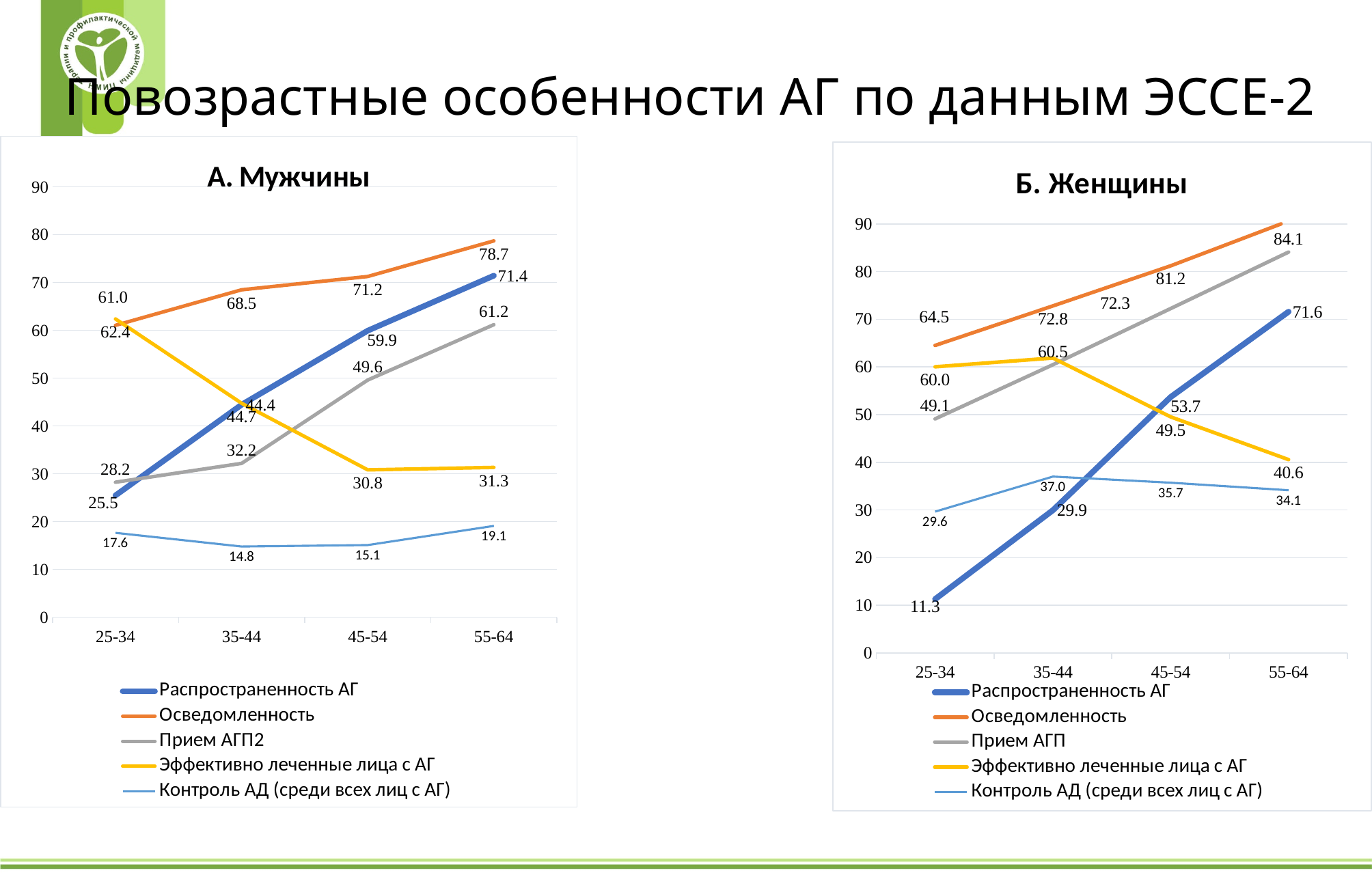
In the chart titled "Б. Женщины", which is larger for the 45-54 age group: Распространенность АГ or Эффективно леченные лица с АГ? Распространенность АГ In the chart titled "А. Мужчины", how many series does the legend list? 5 In the chart titled "А. Мужчины", which age group has the lowest value for Контроль АД (среди всех лиц с АГ)? 35-44 What type of chart is the chart titled "Б. Женщины"? line chart In the chart titled "А. Мужчины", what is the value of Осведомленность for the 25-34 age group? 61.0 In the chart titled "Б. Женщины", what is the value of Распространенность АГ for the 25-34 age group? 11.3 In the chart titled "Б. Женщины", how many age groups are shown on the x axis? 4 In the chart titled "А. Мужчины", what is the difference between Осведомленность and Распространенность АГ for the 35-44 age group? 24.1 In the chart titled "А. Мужчины", does the Эффективно леченные лица с АГ series rise or fall from 25-34 to 45-54? fall In the chart titled "Б. Женщины", what is the difference in Распространенность АГ between the 55-64 and 25-34 age groups? 60.3 In the chart titled "Б. Женщины", what is the value of Осведомленность for the 45-54 age group? 81.2 In the chart titled "А. Мужчины", what is the value of Распространенность АГ for the 55-64 age group? 71.4